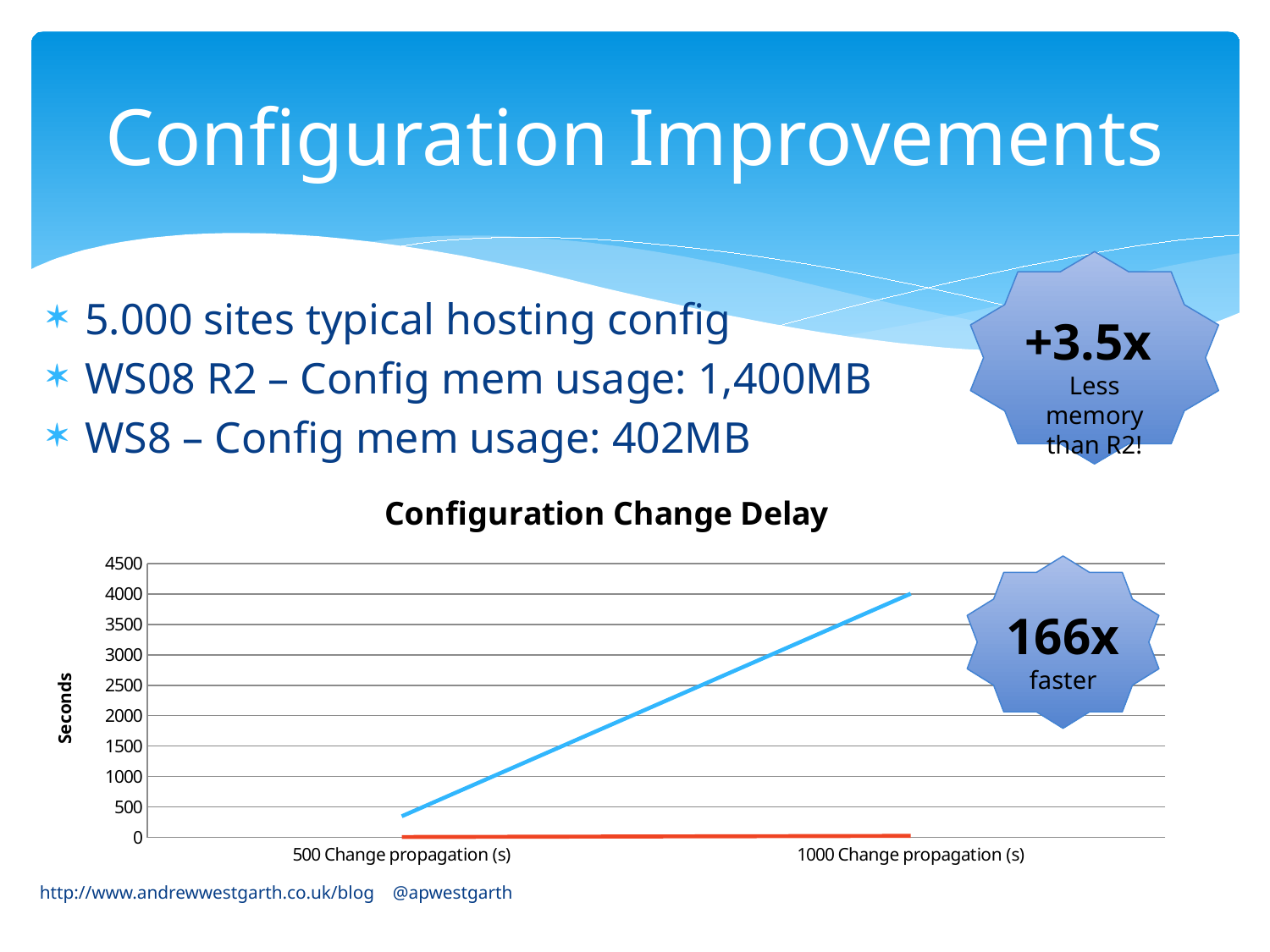
What is the label on the vertical axis of the chart? Seconds Does the blue line rise or fall from 500 Change propagation (s) to 1000 Change propagation (s)? rise Is the value of the blue line at 1000 Change propagation (s) greater or less than 3500? greater At 1000 Change propagation (s), which line has the larger value, the blue line or the red line? the blue line Is the value of the blue line at 500 Change propagation (s) greater or less than 500? less What kind of chart is shown on the slide? line chart Is the value of the red line at 1000 Change propagation (s) greater or less than 500? less What is the title of the chart? Configuration Change Delay What is the highest value shown on the vertical axis of the chart? 4500 How many lines are plotted on the chart? 2 How many categories are shown on the x axis of the chart? 2